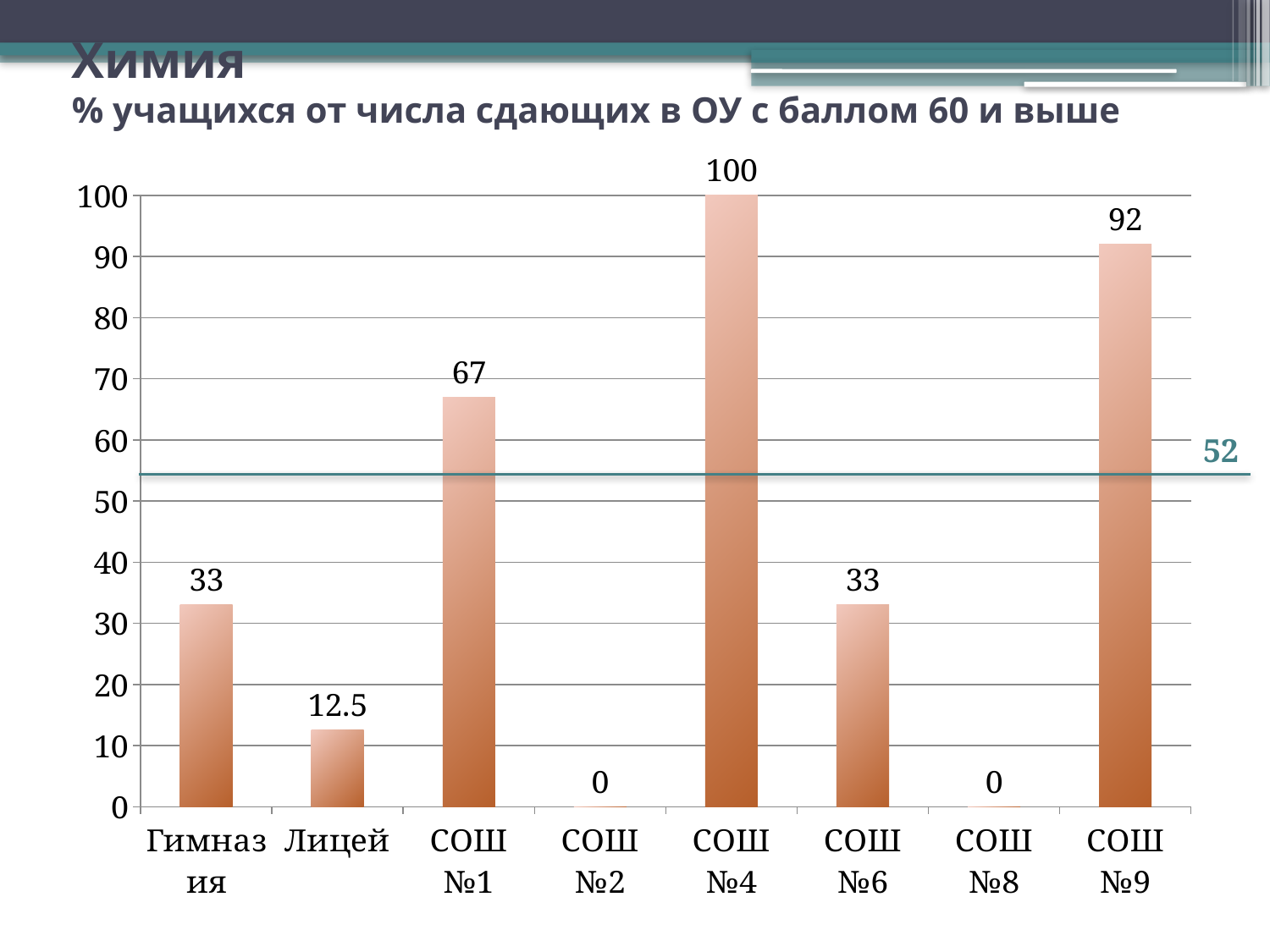
How many categories are shown on the x axis? 8 What kind of chart is shown on the slide? bar chart What is the value for Лицей? 12.5 What is the value for СОШ №1? 67 What is the value for СОШ №9? 92 Which is larger, the value for Гимназия or the value for Лицей? Гимназия What value is labelled on the horizontal line drawn across the chart? 52 How many categories have a value of 0? 2 What is the difference between the values for СОШ №4 and СОШ №9? 8 Is the value for СОШ №6 greater or less than 40? less What is the difference between the values for СОШ №1 and Гимназия? 34 Which category has the highest value? СОШ №4